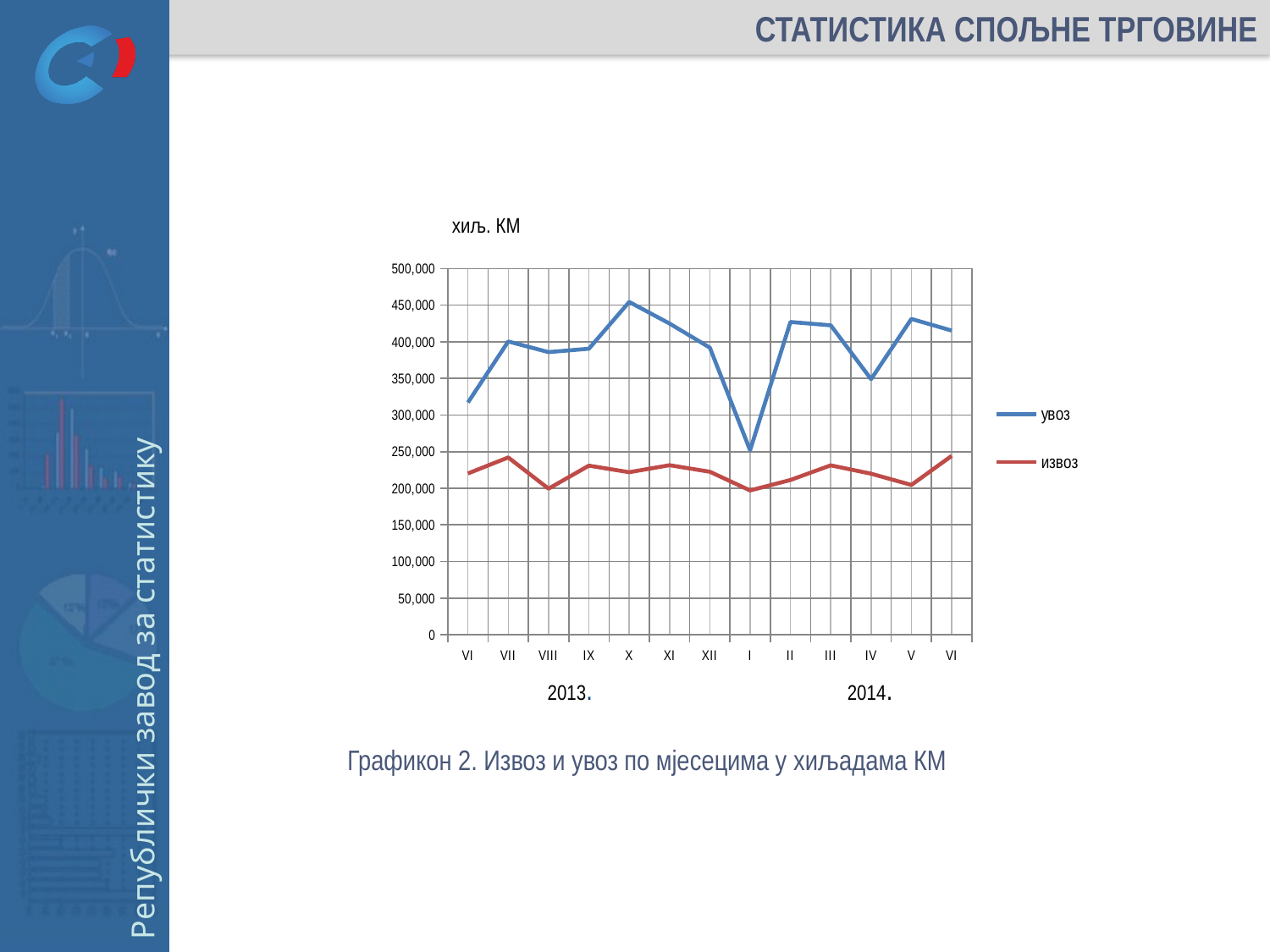
How many monthly points are plotted along the x axis? 13 Is the value of увоз for X 2013 greater or less than 400,000? greater What are the two series named in the legend? увоз and извоз In which month is the увоз line at its lowest? I (2014) In which month is the увоз line at its highest? X (2013) Is the value of увоз for II 2014 greater or less than 400,000? greater Is the value of увоз for VI 2013 greater or less than 300,000? greater Does the увоз line rise or fall from X 2013 to I 2014? fall What kind of chart is shown on the slide? line chart How many series does the legend list? 2 Which series has the larger value in XII 2013, увоз or извоз? увоз